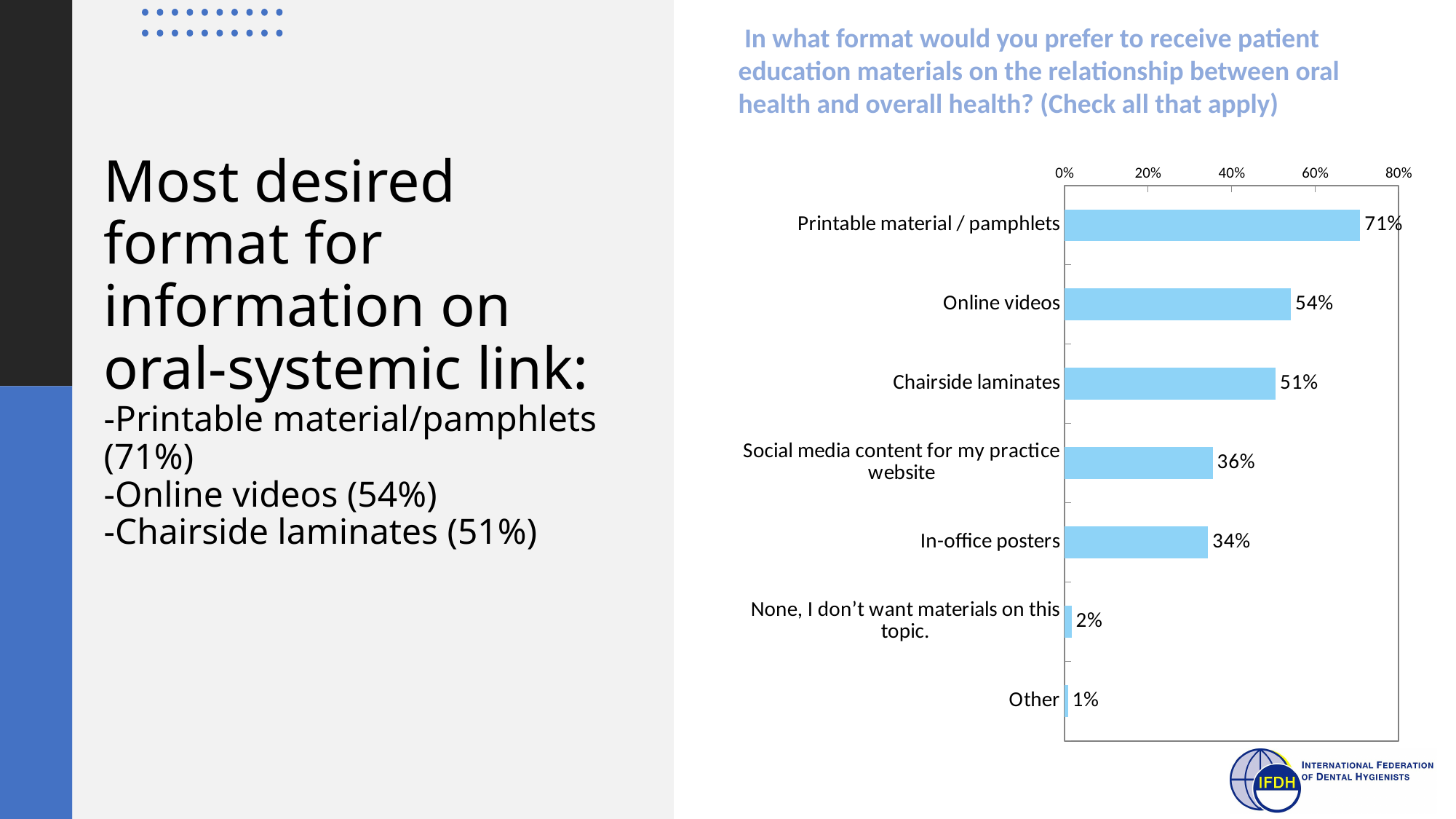
What type of chart is shown on the slide? Bar chart Which format has the highest percentage? Printable material / pamphlets What is the value for Online videos? 54% What is the difference between Chairside laminates and In-office posters? 17% What is the highest value shown on the chart's percentage axis? 80% Which category has the lowest percentage? Other Which is larger, Online videos or Chairside laminates? Online videos What is the value for In-office posters? 34% What is the difference between Printable material / pamphlets and Online videos? 17% What percentage chose Social media content for my practice website? 36% What percentage of respondents prefer printable material / pamphlets? 71% How many categories are shown in the chart? 7